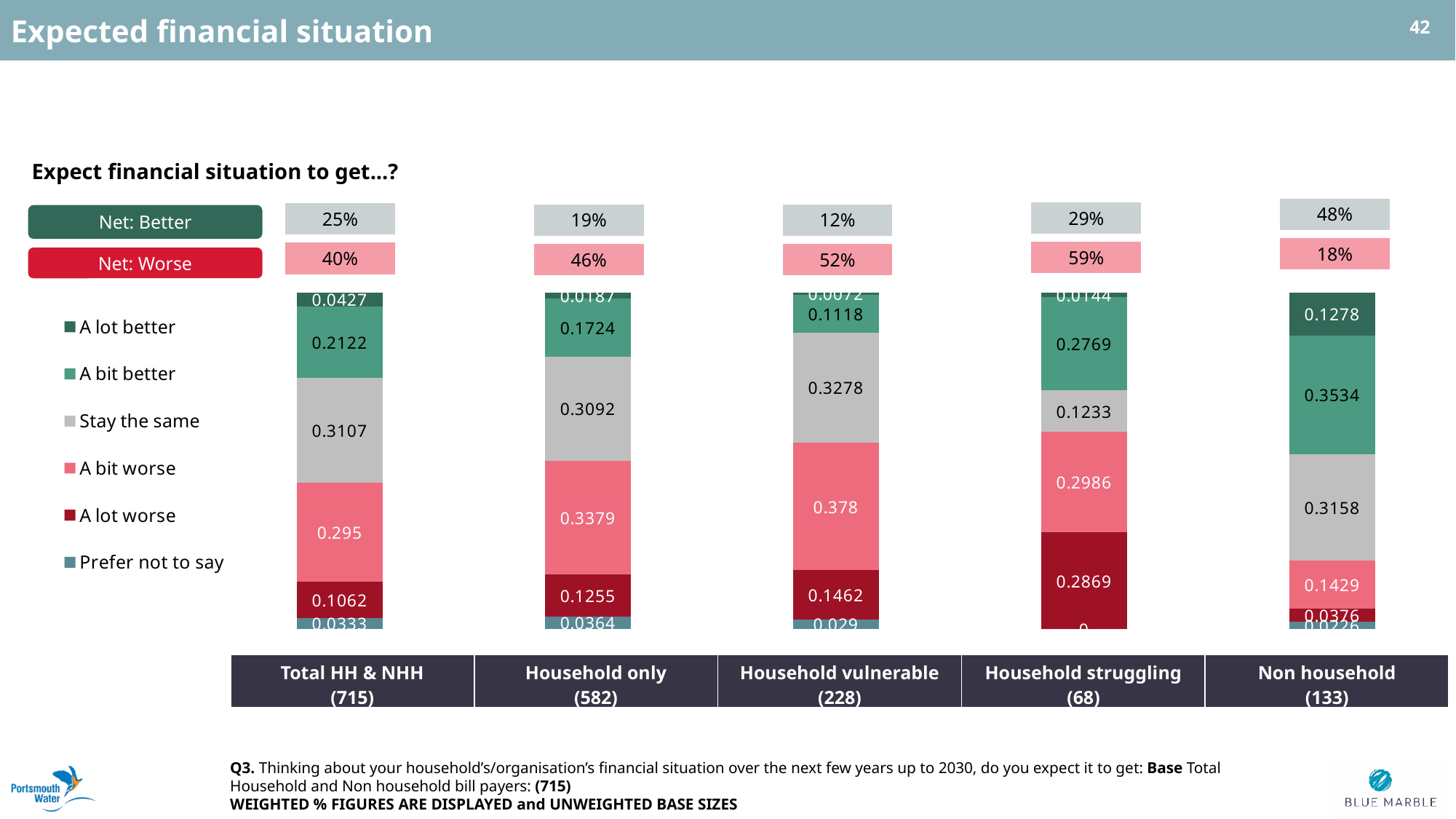
What is the value for "Stay the same" in the Household only bar? 0.3092 Which group has the highest Net: Worse figure? Household struggling What is the value for "A bit better" in the Non household bar? 0.3534 For Total HH & NHH, how much higher is the Net: Worse figure than the Net: Better figure? 15% Which group has the lowest Net: Better figure? Household vulnerable How many groups (bars) are shown in the chart? 5 What kind of chart is shown on the slide? Stacked bar chart What is the value for "A lot worse" in the Household struggling bar? 0.2869 Which is larger: the "A bit worse" value for Household vulnerable or for Household only? Household vulnerable How many series does the legend list? 6 What is the Net: Better figure shown for Non household? 48% What is the chart's title text above the bars? Expect financial situation to get...?